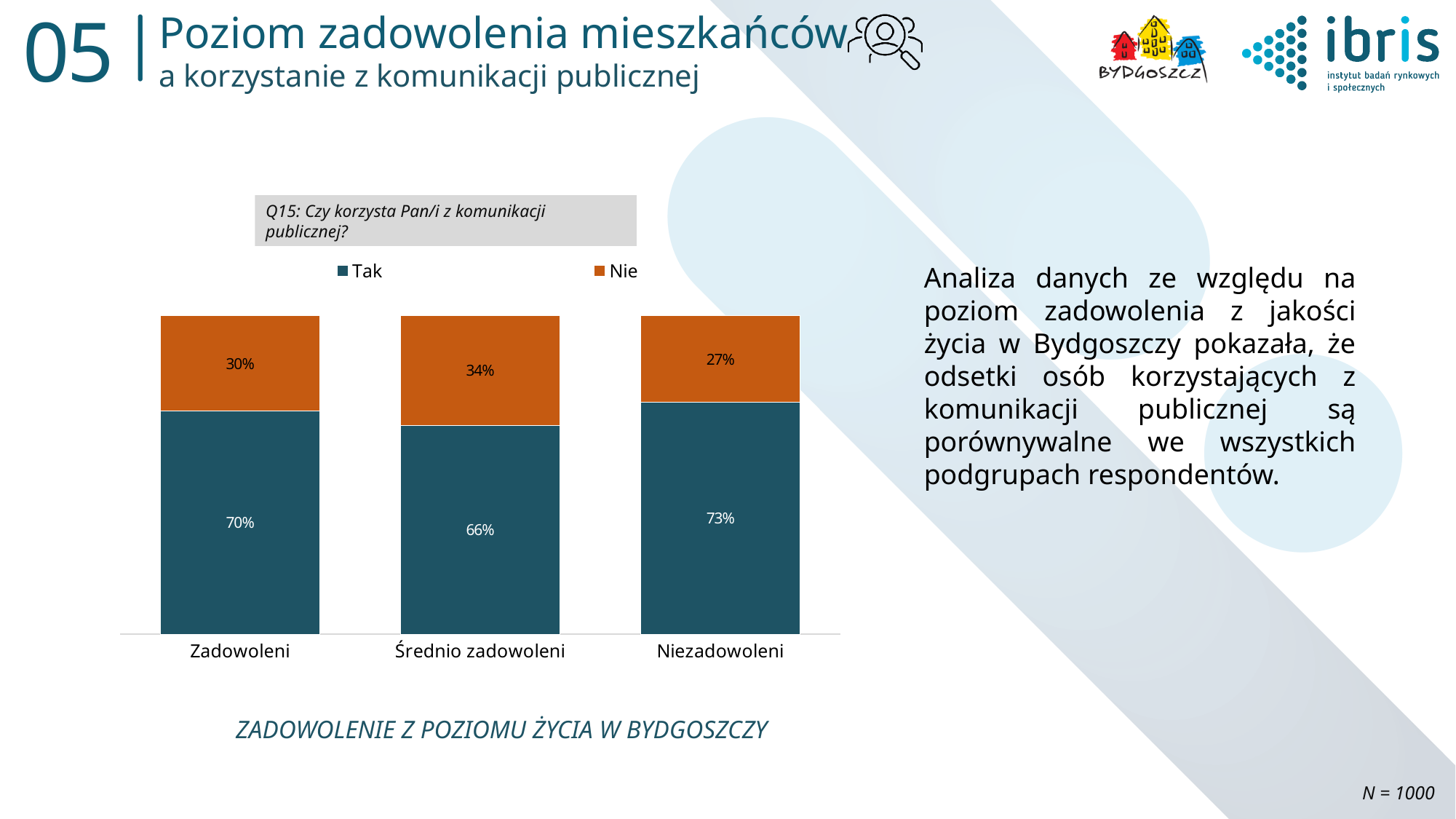
Which category has the highest 'Nie' value? Średnio zadowoleni Is the 'Nie' value larger for Zadowoleni or for Niezadowoleni? Zadowoleni What is the 'Nie' value for Zadowoleni? 30% What kind of chart is shown? Stacked bar chart What is the 'Nie' value for Średnio zadowoleni? 34% Which category has the highest 'Tak' value? Niezadowoleni What is the 'Tak' value for Zadowoleni? 70% How many series does the legend list? 2 What is the difference between the 'Tak' values for Niezadowoleni and Średnio zadowoleni? 7 percentage points How many categories are shown on the x axis? 3 What is the 'Tak' value for Niezadowoleni? 73% Which category has the lowest 'Tak' value? Średnio zadowoleni